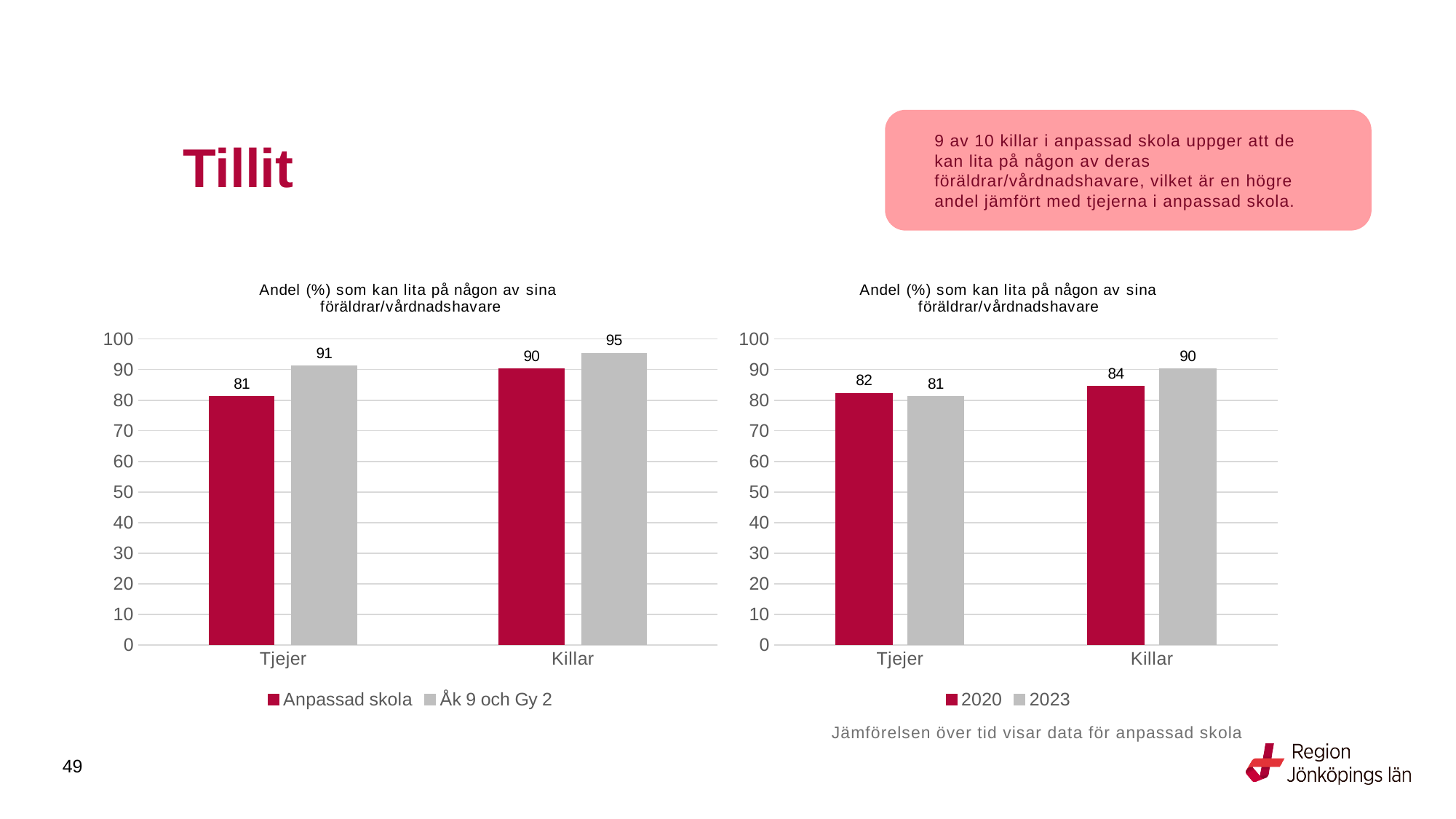
How many series does the legend of the right chart list? 2 In the left chart, what is the difference between the Åk 9 och Gy 2 value and the Anpassad skola value for Tjejer? 10 In the left chart, what is the value for Tjejer in the Anpassad skola series? 81 In the left chart, which category has the highest value in the Anpassad skola series? Killar What are the two series listed in the legend of the left chart? Anpassad skola and Åk 9 och Gy 2 In the right chart, what is the difference between the 2023 and 2020 values for Killar? 6 In the left chart, what is the value for Killar in the Åk 9 och Gy 2 series? 95 In the right chart, what is the value for Killar in 2023? 90 In the right chart, which category has the lowest value in the 2023 series? Tjejer In the left chart, which is larger for Killar: Anpassad skola or Åk 9 och Gy 2? Åk 9 och Gy 2 What kind of chart is the left chart? Bar chart In the right chart, what is the value for Tjejer in 2020? 82